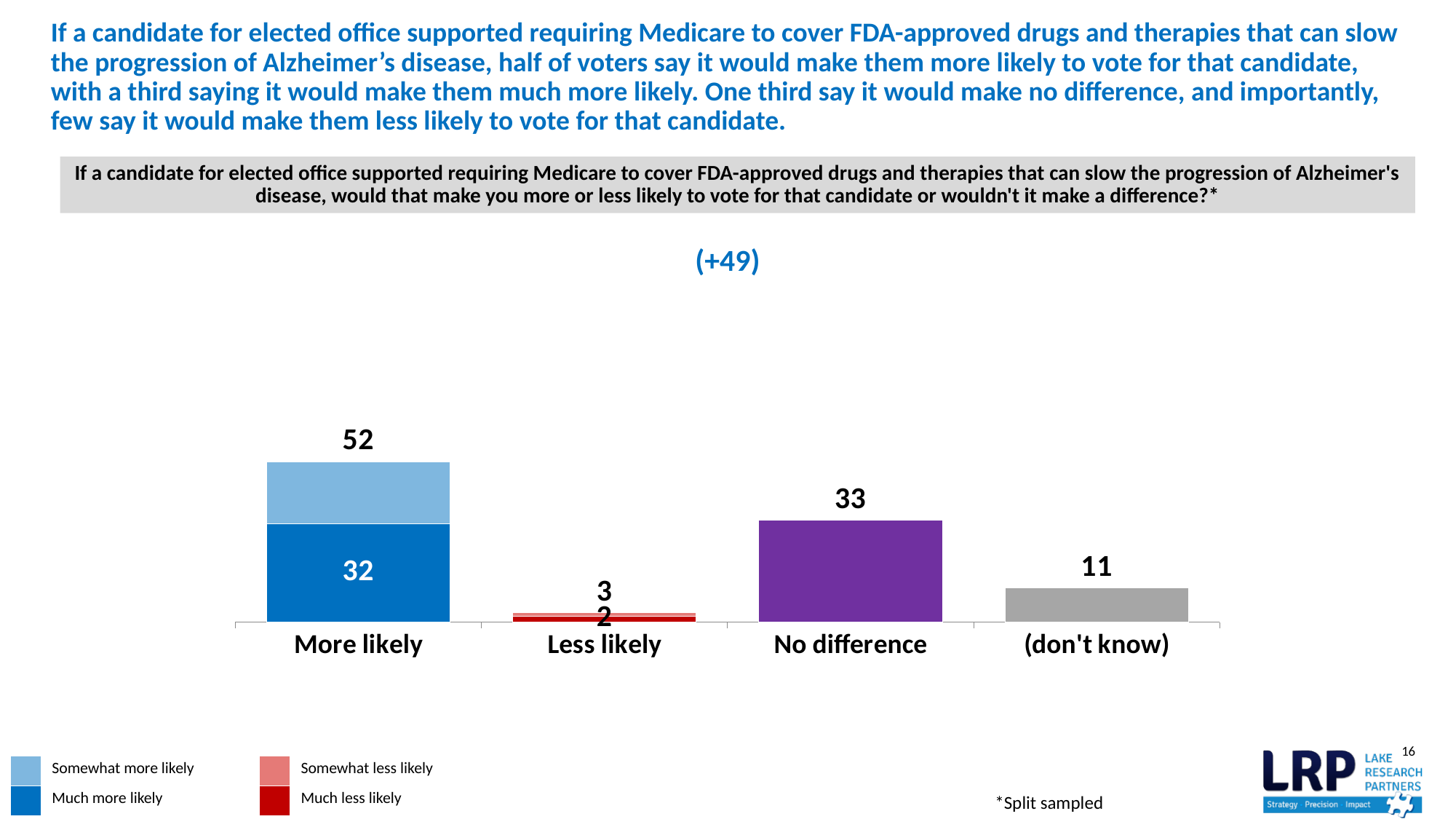
What is the total value shown for the "More likely" bar? 52 What is the value for "No difference"? 33 Which is larger, the value for "No difference" or the value for "(don't know)"? No difference Which category has the highest total value? More likely What is the difference between the total for "More likely" and the value for "No difference"? 19 What is the total value shown for the "Less likely" bar? 3 How many entries does the legend list? 4 What net figure is printed above the chart? (+49) What is the value for "(don't know)"? 11 Which category has the lowest total value? Less likely What is the value of the "Much more likely" segment in the "More likely" bar? 32 How many categories are shown on the x axis? 4